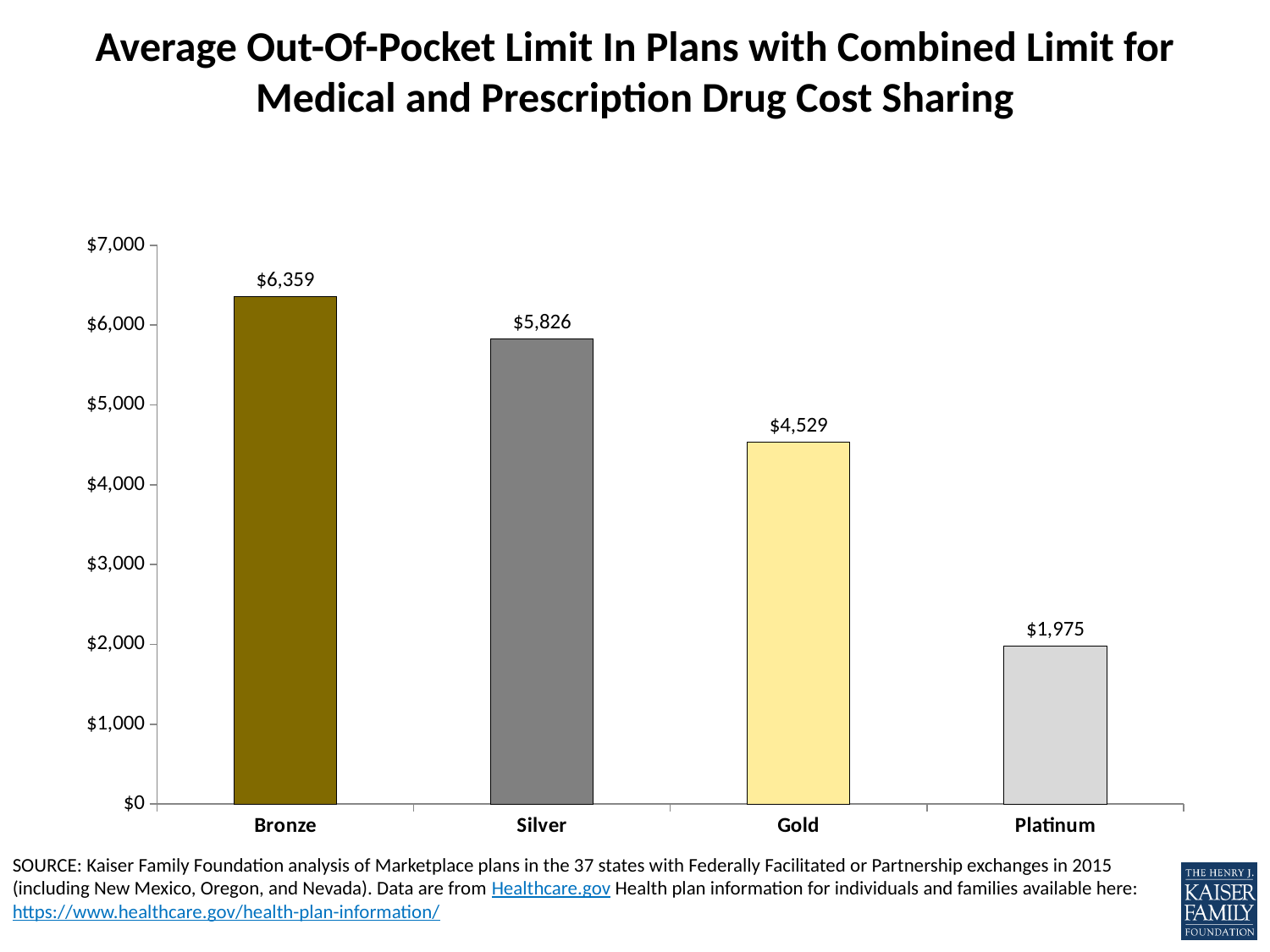
What is the average out-of-pocket limit for Platinum plans? $1,975 What is the difference between the average out-of-pocket limits for Bronze and Silver plans? $533 How many plan types are shown on the chart? 4 What is the average out-of-pocket limit for Silver plans? $5,826 What is the average out-of-pocket limit for Bronze plans? $6,359 What kind of chart is shown on the slide? Bar chart Which plan type has the lowest average out-of-pocket limit? Platinum Which has a larger average out-of-pocket limit, Silver or Gold? Silver Is the value for Gold greater or less than $5,000? less Which plan type has the highest average out-of-pocket limit? Bronze What is the average out-of-pocket limit for Gold plans? $4,529 What is the difference between the average out-of-pocket limits for Gold and Platinum plans? $2,554